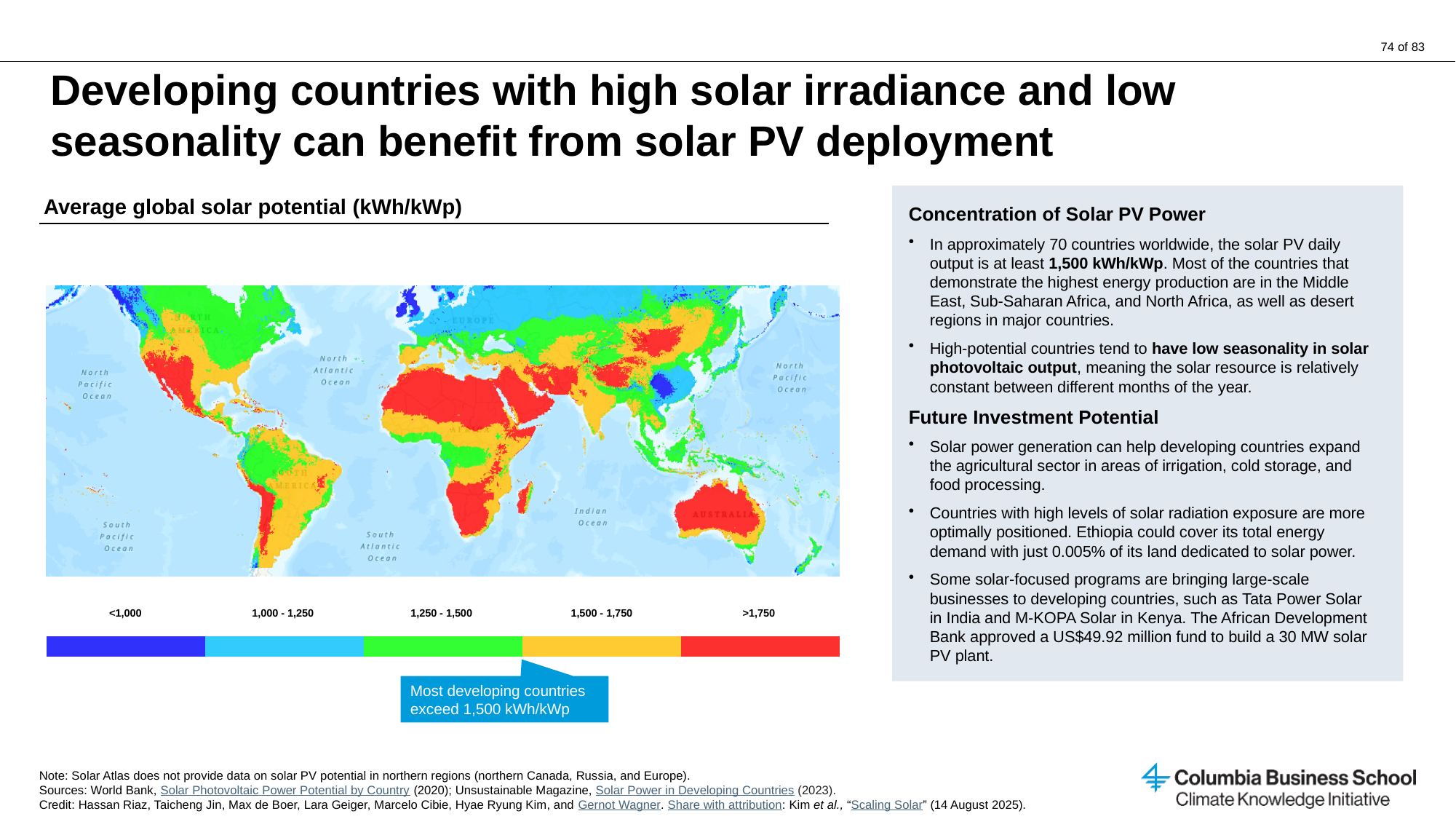
How many value ranges does the map's colour legend list? 5 Which value range does the yellow colour on the map represent? 1,500 - 1,750 What is the title of the map chart? Average global solar potential (kWh/kWp) Which value range does the dark blue colour on the map represent? <1,000 Which value range does the green colour on the map represent? 1,250 - 1,500 What kind of chart is shown on the slide? A world map (heat map) of solar potential Is the solar potential shown for the Sahara region of North Africa on the map greater or less than 1,750 kWh/kWp? greater Which value range does the red colour on the map represent? >1,750 According to the callout below the legend, what threshold do most developing countries exceed? 1,500 kWh/kWp What colour on the map represents the 1,000 - 1,250 range? Light blue Is the solar potential shown for Australia on the map greater or less than 1,750 kWh/kWp? greater What unit is the solar potential on the map measured in? kWh/kWp